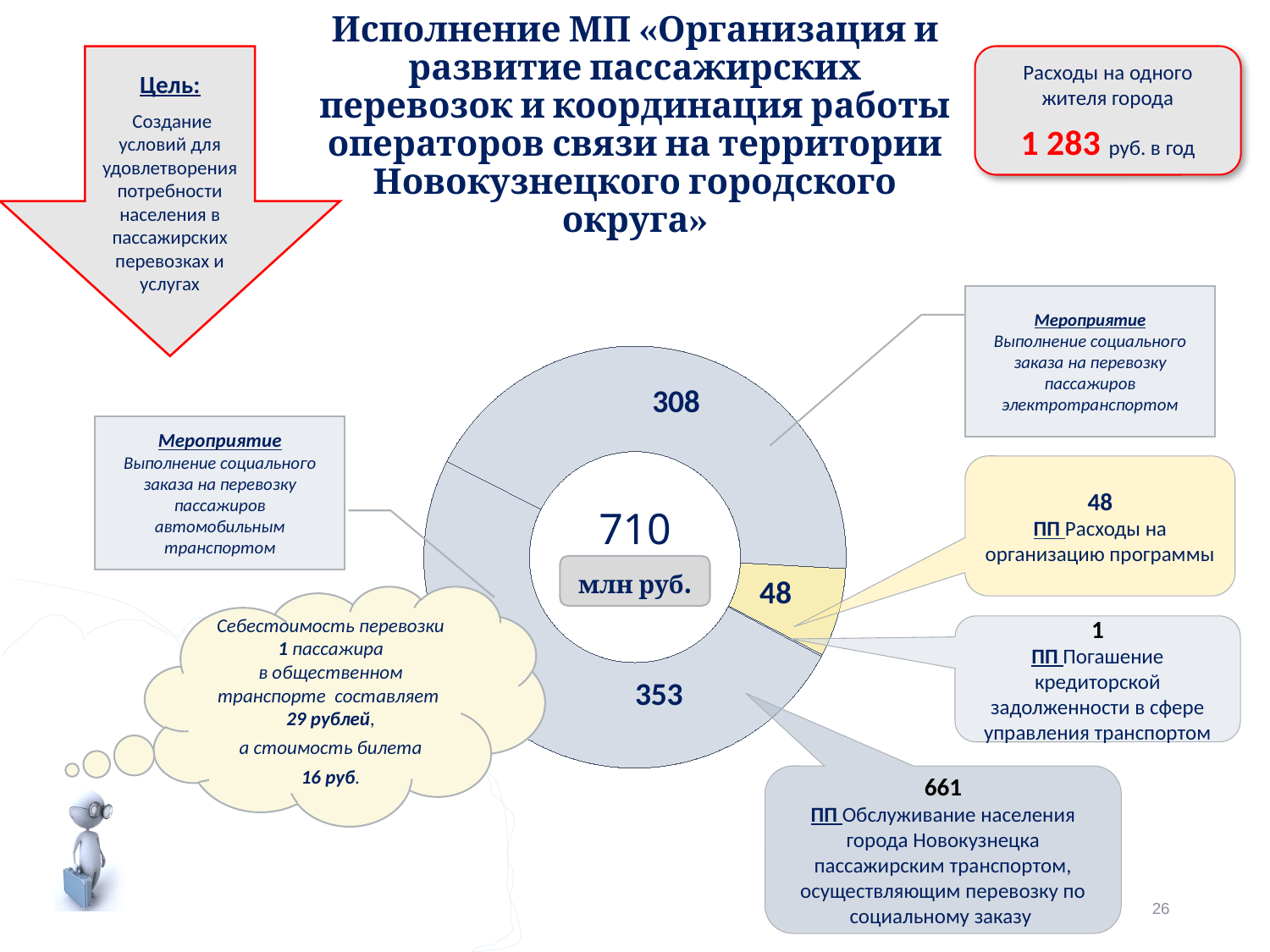
What is the difference between the 353 segment and the 308 segment? 45 How many segments does the doughnut chart have? 4 What is the combined value of the two transport segments (308 and 353)? 661 What is the value of the yellow segment of the doughnut chart? 48 What kind of chart is shown on the slide? doughnut (pie) chart What value is shown in the centre of the doughnut chart? 710 млн руб. What is the value of the segment for the social order for passenger transport by automobile transport (автомобильным транспортом)? 353 Which is larger: the segment for electric transport (308) or the segment for automobile transport (353)? automobile transport (353) What is the value of the segment for the social order for passenger transport by electric transport (электротранспортом)? 308 What colour is the segment labelled 48? yellow Which segment of the doughnut chart is the smallest? 1 (погашение кредиторской задолженности) Which segment of the doughnut chart is the largest? 353 (перевозка пассажиров автомобильным транспортом)